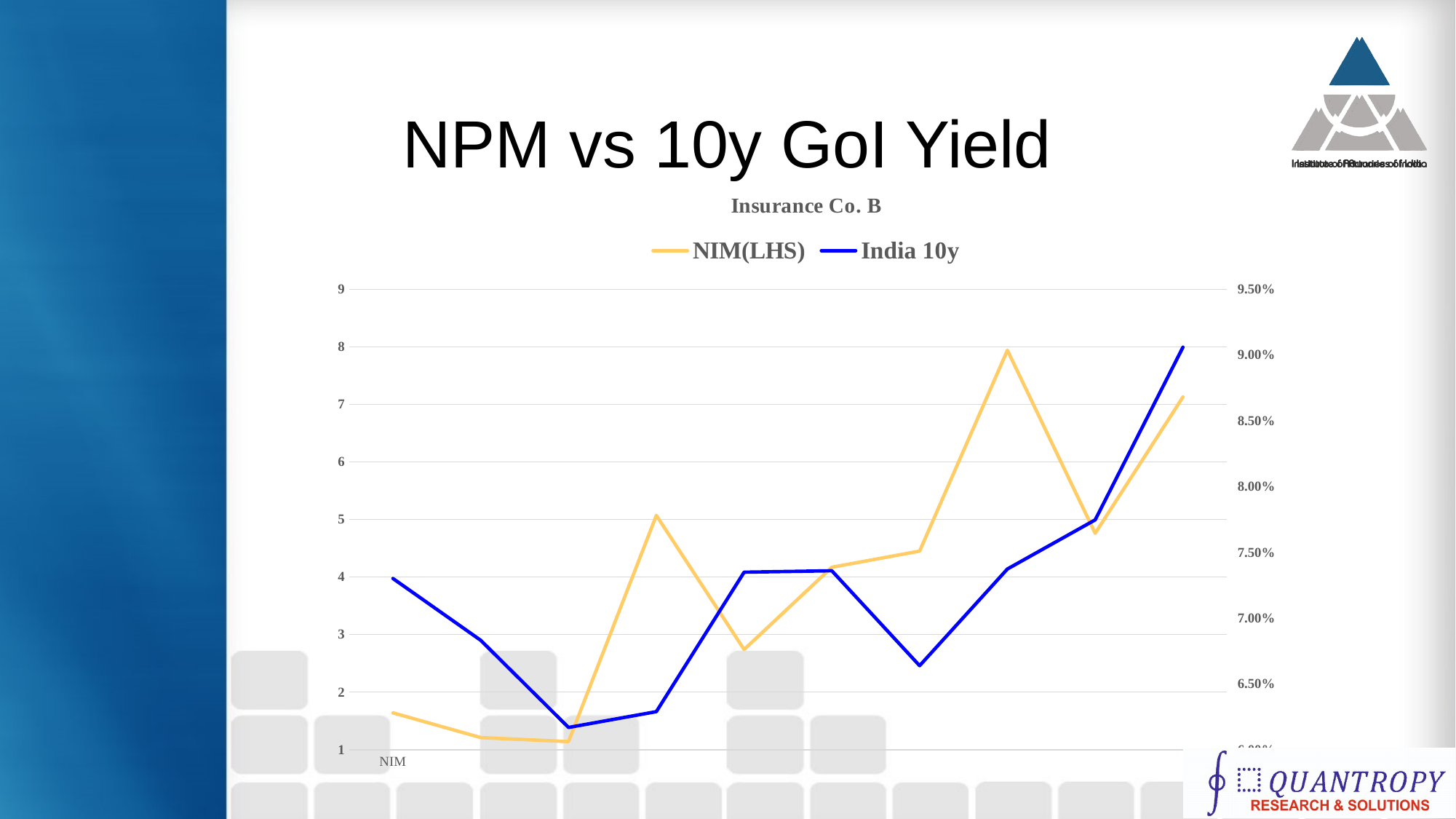
Overall, does the NIM(LHS) line rise or fall from its first point to its last point? rise Is the first (leftmost) point of the NIM(LHS) line greater or less than 2 on the left axis? less Overall, does the India 10y line rise or fall from left to right? rise Is the last (rightmost) point of the India 10y line greater or less than 8.50% on the right axis? greater How many data points does the NIM(LHS) line have? 10 Is the first (leftmost) point of the India 10y line greater or less than 7.00% on the right axis? greater What is the title shown above the chart's legend? Insurance Co. B Which colour is used for the India 10y series? blue How many series does the legend list? 2 What kind of chart is shown on the slide? line chart